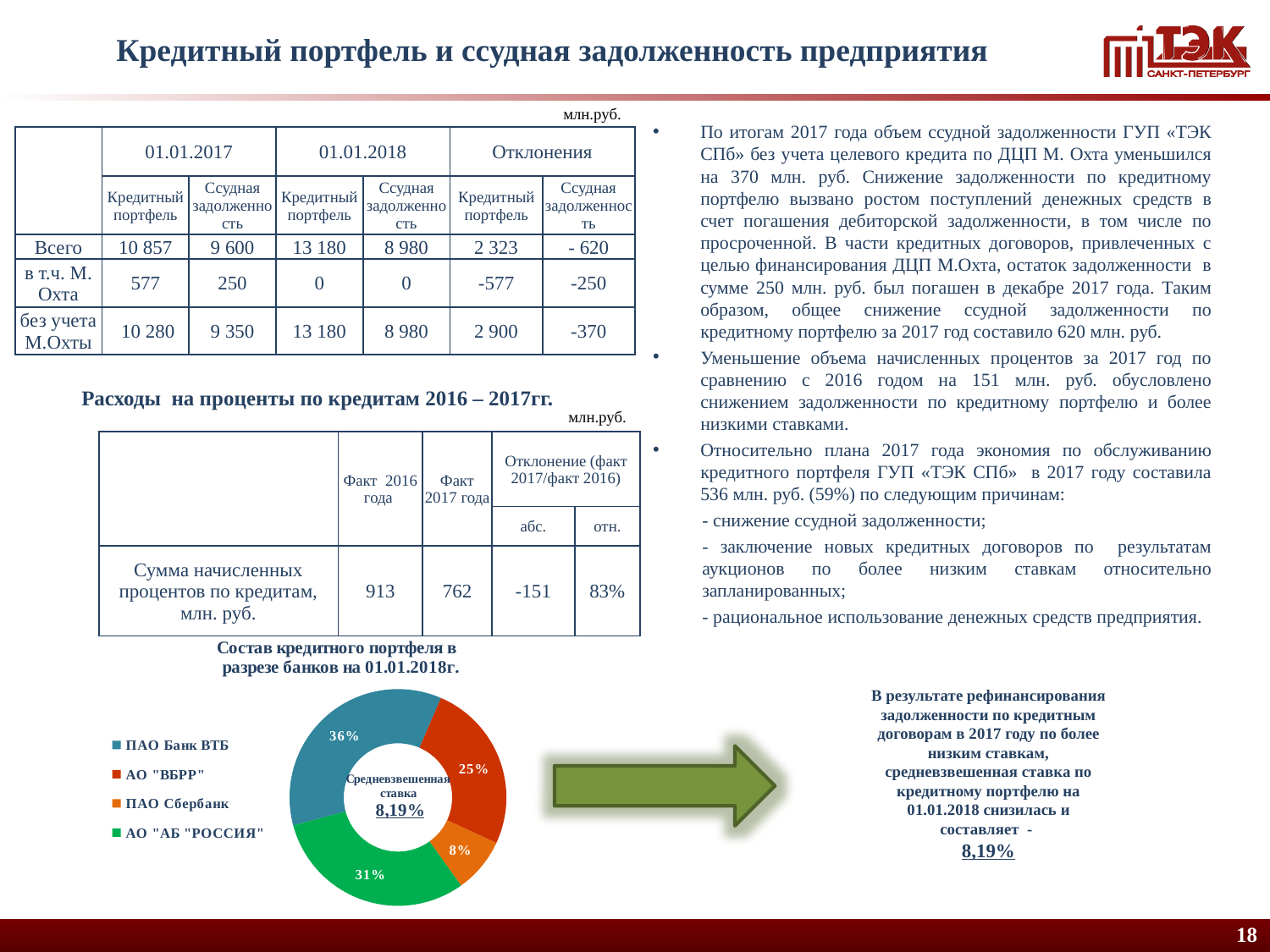
What share of the credit portfolio does ПАО Банк ВТБ hold in the chart? 36% What is the difference in percentage points between the shares of ПАО Банк ВТБ and АО "АБ "РОССИЯ""? 5 percentage points What weighted average rate (Средневзвешенная ставка) is shown in the centre of the chart? 8,19% What share of the credit portfolio does АО "ВБРР" hold in the chart? 25% What is the title of the chart on the slide? Состав кредитного портфеля в разрезе банков на 01.01.2018г. What share of the credit portfolio does ПАО Сбербанк hold in the chart? 8% What kind of chart is shown on the slide? doughnut (pie) chart What share of the credit portfolio does АО "АБ "РОССИЯ"" hold in the chart? 31% Which bank has the smallest share of the credit portfolio in the chart? ПАО Сбербанк How many banks are listed in the chart's legend? 4 Which bank has the largest share of the credit portfolio in the chart? ПАО Банк ВТБ Which has a larger share of the credit portfolio, АО "ВБРР" or АО "АБ "РОССИЯ""? АО "АБ "РОССИЯ""